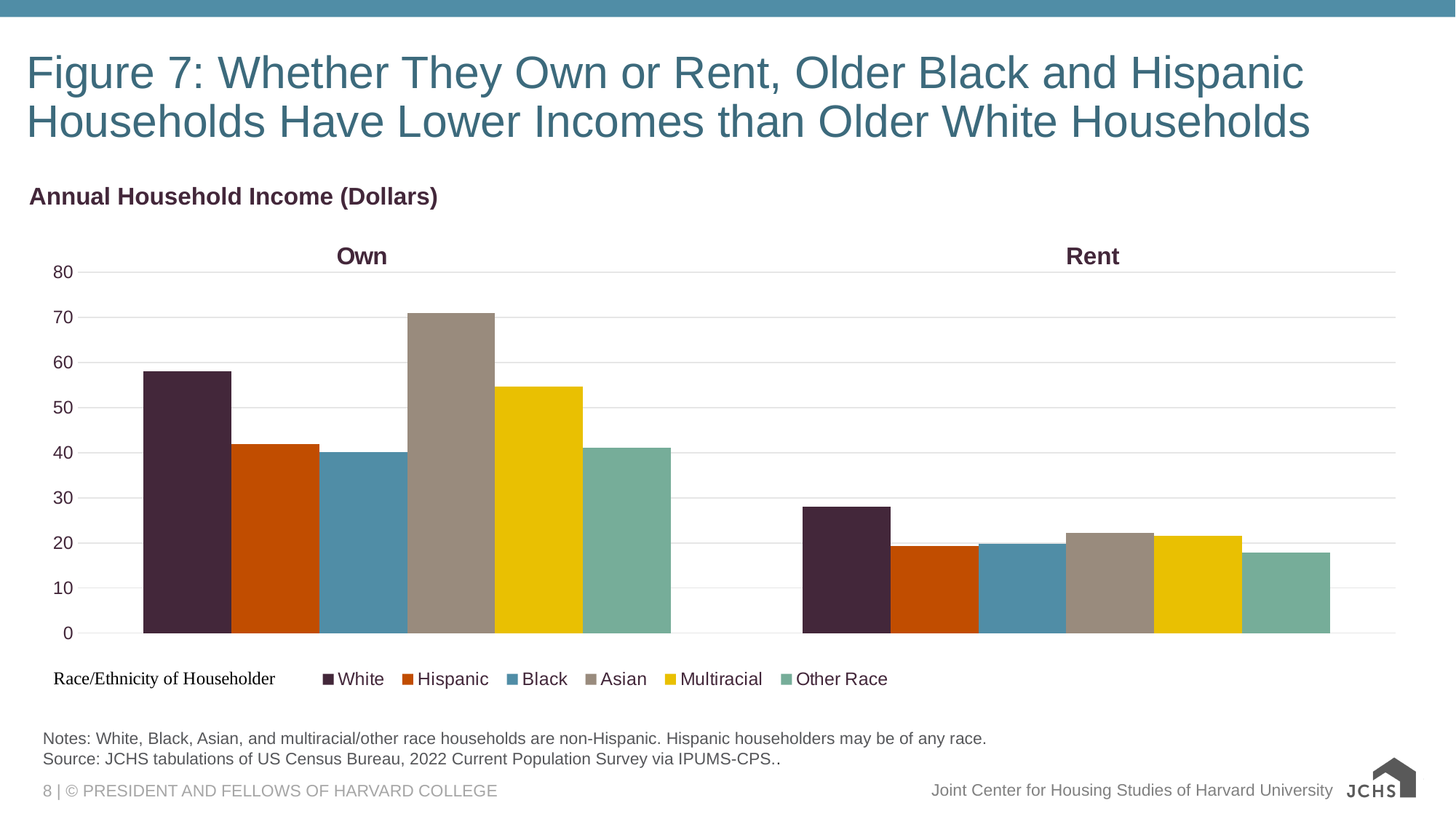
Is the value for White owners (Own) greater or less than 50? greater Is the value for Asian owners (Own) greater or less than 60? greater How many series does the legend list? 6 How many tenure categories are shown on the x axis? 2 Which race/ethnicity has the highest annual household income among renters (Rent)? White Which is larger: the value for Asian owners (Own) or White owners (Own)? Asian owners (Own) What is the axis title shown above the chart? Annual Household Income (Dollars) Which race/ethnicity has the highest annual household income among owners (Own)? Asian Is the value for Hispanic owners (Own) greater or less than 50? less Which is larger: the value for Hispanic owners (Own) or Hispanic renters (Rent)? Hispanic owners (Own) What kind of chart is shown on the slide? bar chart